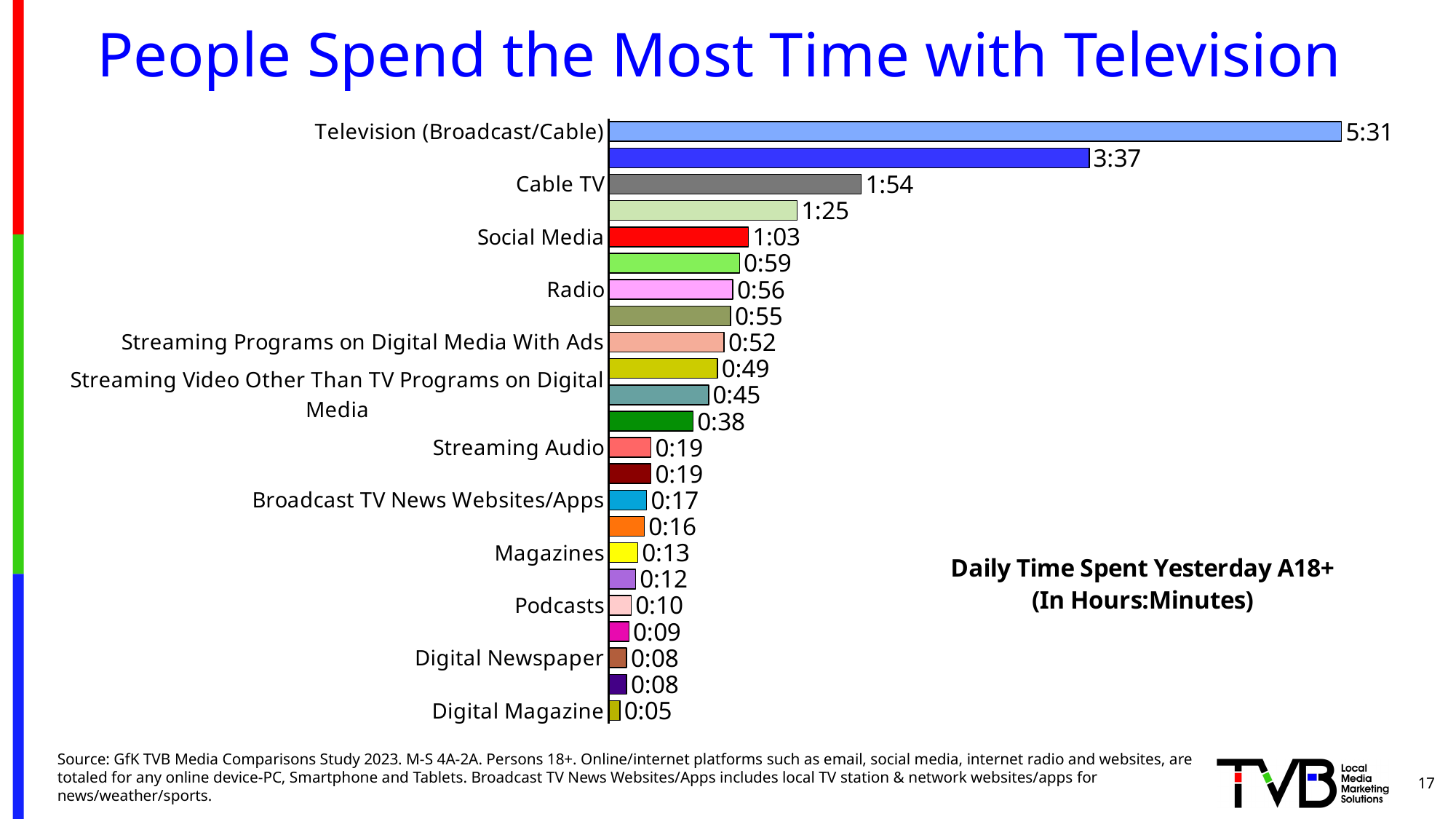
How much daily time is shown for Social Media? 1:03 Which labeled category has the highest daily time spent? Television (Broadcast/Cable) What kind of chart is shown on the slide? Bar chart How many bars are plotted in the chart? 23 What is the value for Digital Magazine? 0:05 Which is larger, the value for Magazines or the value for Podcasts? Magazines What is the value for Radio? 0:56 What is the value shown for Cable TV? 1:54 What is the daily time spent with Television (Broadcast/Cable)? 5:31 What is the difference between the values for Social Media and Radio? 0:07 Which labeled category has the lowest daily time spent? Digital Magazine What is the value for Streaming Video Other Than TV Programs on Digital Media? 0:45